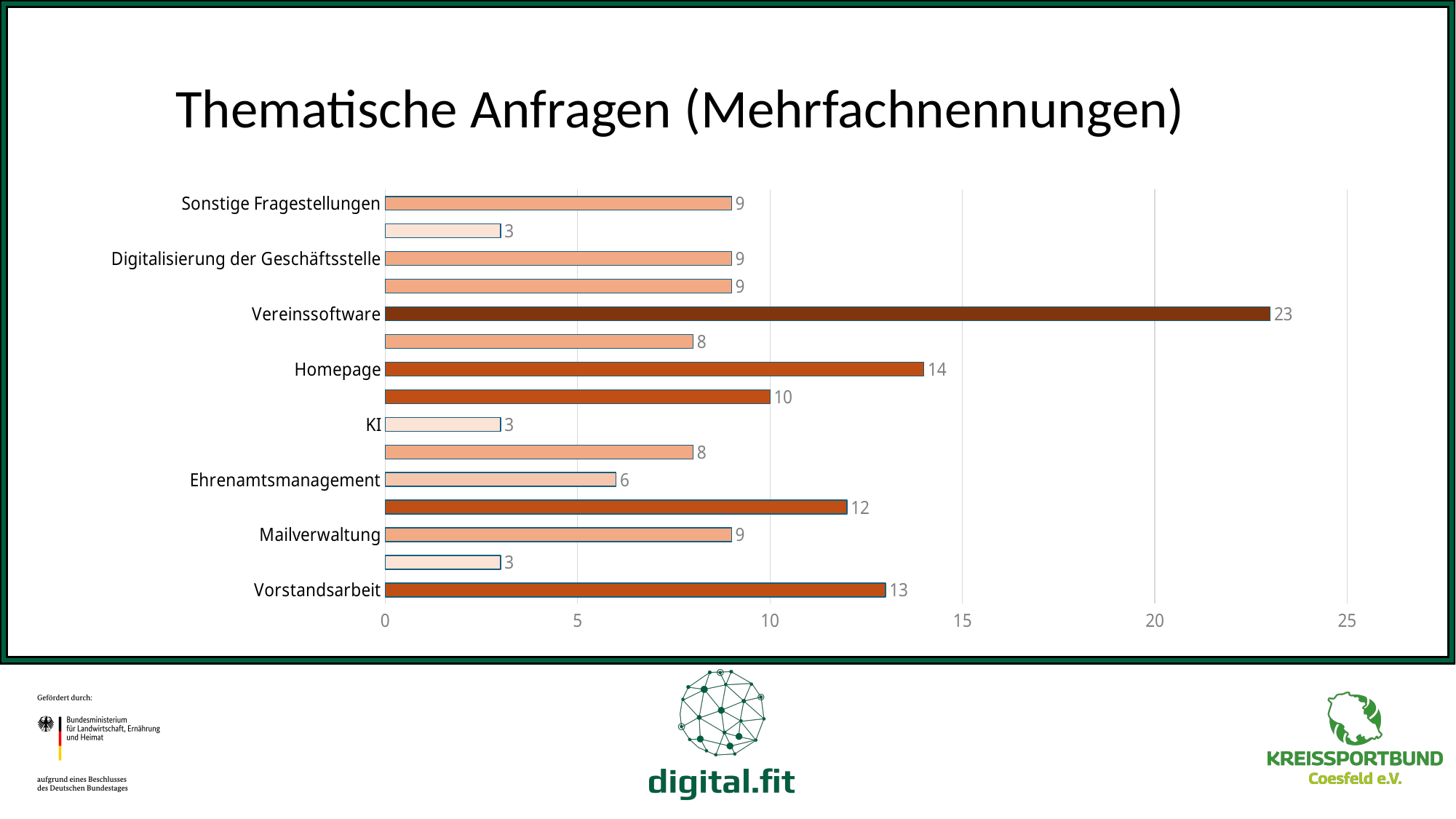
Which labelled category has the highest value? Vereinssoftware Which is larger, the value for Vorstandsarbeit or the value for Mailverwaltung? Vorstandsarbeit What is the value for Ehrenamtsmanagement? 6 What is the difference between the values for Vereinssoftware and Homepage? 9 Which labelled category has the lowest value? KI What is the value for Vorstandsarbeit? 13 What is the title of the chart? Thematische Anfragen (Mehrfachnennungen) What kind of chart is shown on the slide? bar chart Is the value for Vereinssoftware greater or less than 20? greater What is the value for Homepage? 14 What is the value for KI? 3 What is the value for Vereinssoftware? 23